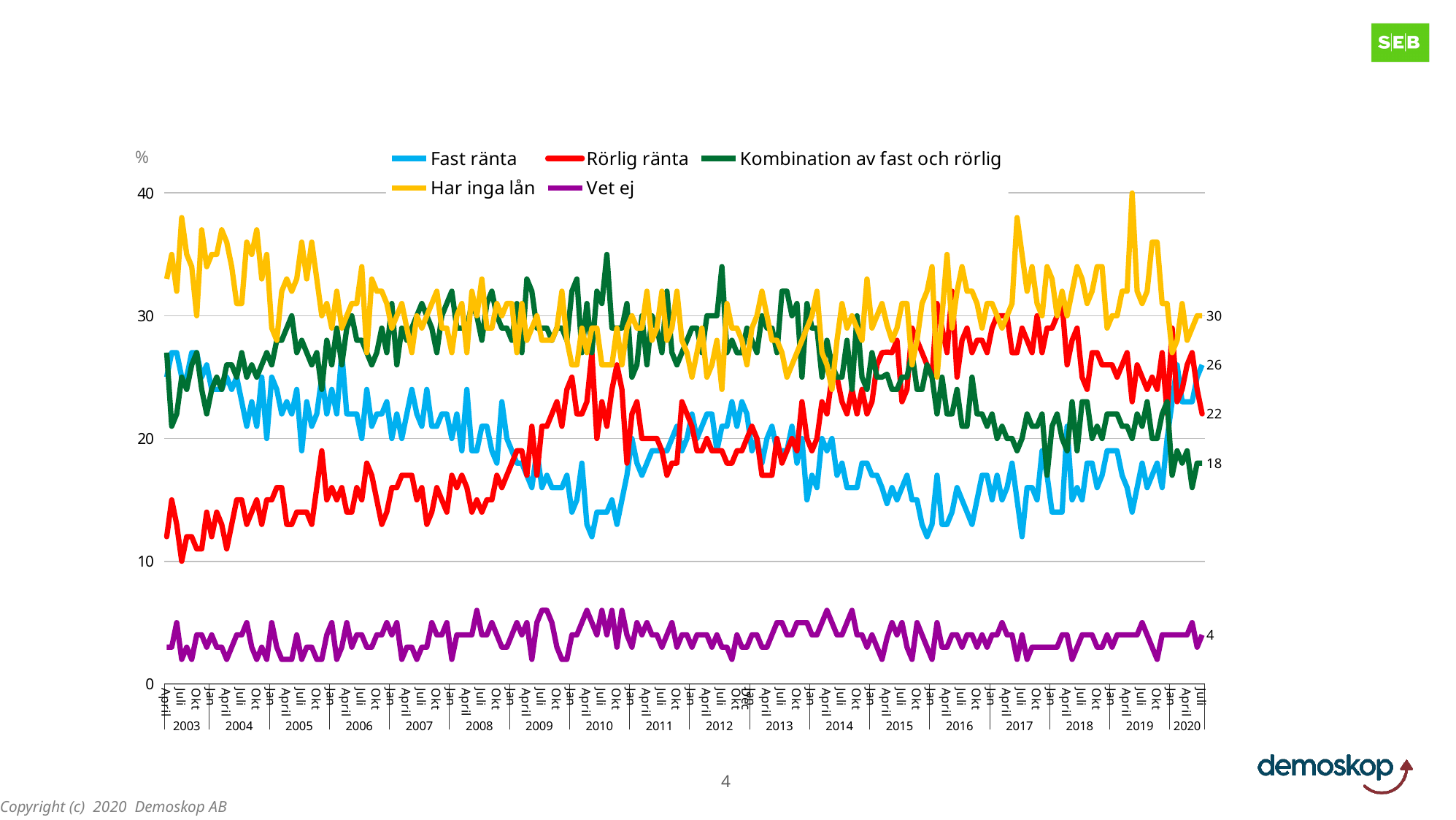
How many series does the legend list? 5 What is the final labelled value for Har inga lån at the right end of the chart? 30 At the last data point, what is the difference between the Fast ränta value and the Rörlig ränta value? 4 Which series has the lowest value at the last data point (Juli 2020)? Vet ej Which series has the highest value at the last data point (Juli 2020)? Har inga lån At the last data point, which is larger: Fast ränta or Kombination av fast och rörlig? Fast ränta What is the final labelled value for Kombination av fast och rörlig at the right end of the chart? 18 What is the final labelled value for Vet ej at the right end of the chart? 4 Is the value for Rörlig ränta at the start of the series in 2003 greater or less than 20? less What is the final labelled value for Fast ränta at the right end of the chart? 26 What is the final labelled value for Rörlig ränta at the right end of the chart? 22 What kind of chart is shown on the slide? line chart